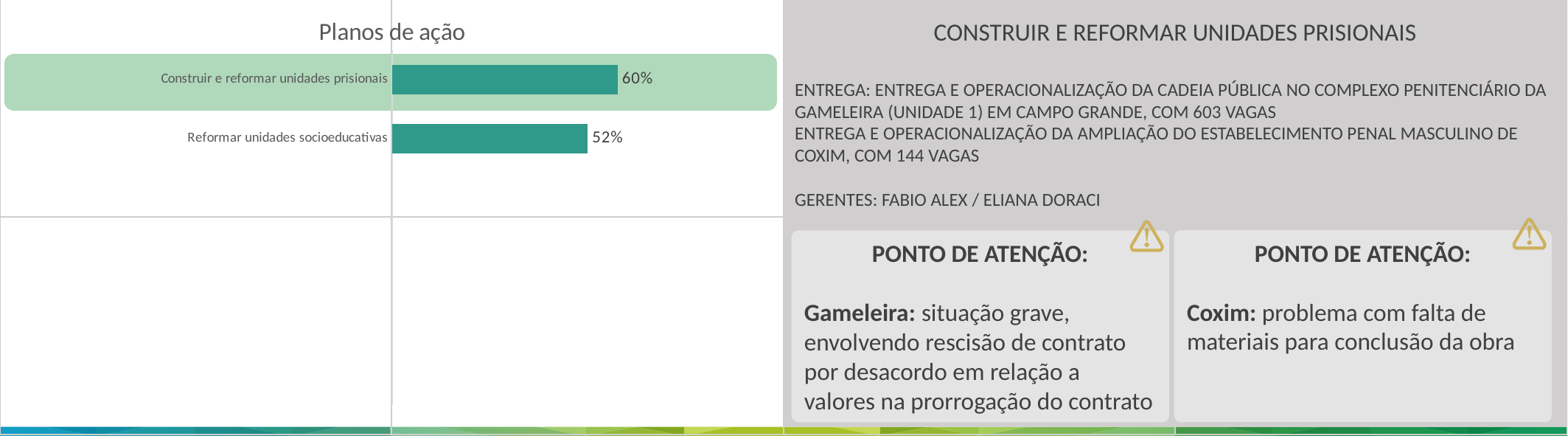
What kind of chart is the 'Planos de ação' chart? Bar chart What is the value for 'Construir e reformar unidades prisionais' in the 'Planos de ação' chart? 60% In the 'Planos de ação' chart, which is larger: 'Construir e reformar unidades prisionais' or 'Reformar unidades socioeducativas'? Construir e reformar unidades prisionais Which category has the lowest value in the 'Planos de ação' chart? Reformar unidades socioeducativas What is the difference between the values for 'Construir e reformar unidades prisionais' and 'Reformar unidades socioeducativas' in the 'Planos de ação' chart? 8% What is the value for 'Reformar unidades socioeducativas' in the 'Planos de ação' chart? 52% How many categories are shown in the 'Planos de ação' chart? 2 Which category in the 'Planos de ação' chart is highlighted with a green background? Construir e reformar unidades prisionais What is the title of the chart on the left of the slide? Planos de ação Which category has the highest value in the 'Planos de ação' chart? Construir e reformar unidades prisionais